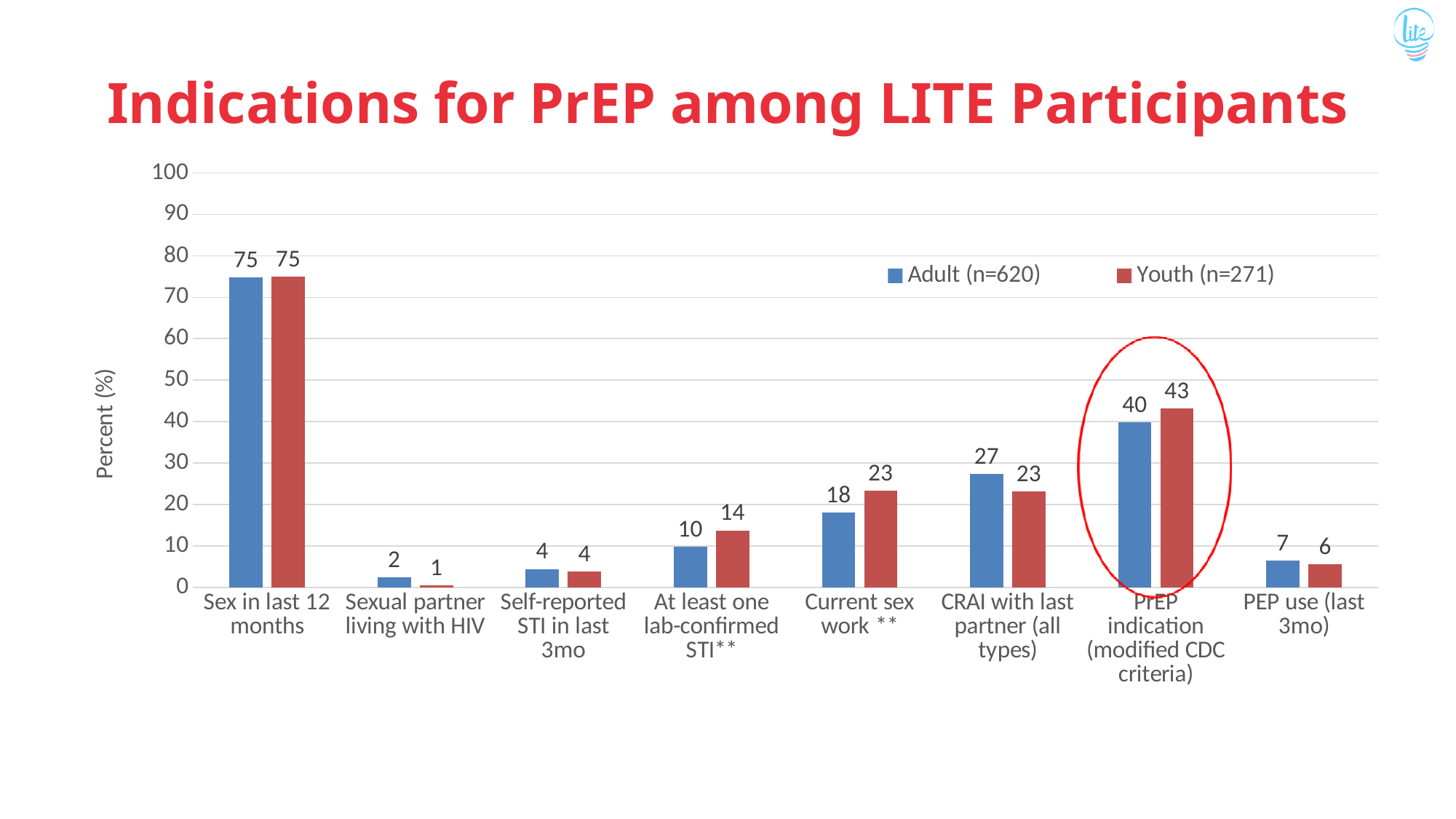
What is the Youth value for Sexual partner living with HIV? 1 What is the Adult value for PrEP indication (modified CDC criteria)? 40 How many series does the legend list? 2 Which category has the lowest Youth value? Sexual partner living with HIV Which is larger for CRAI with last partner (all types): the Adult value or the Youth value? Adult What is the label of the y axis? Percent (%) Which category has the highest Adult value? Sex in last 12 months Is the Youth value for PrEP indication (modified CDC criteria) greater or less than 30? greater What kind of chart is shown on the slide? Bar chart What is the Youth value for Current sex work? 23 What is the difference between the Youth and Adult values for At least one lab-confirmed STI? 4 How many categories are shown on the x axis? 8